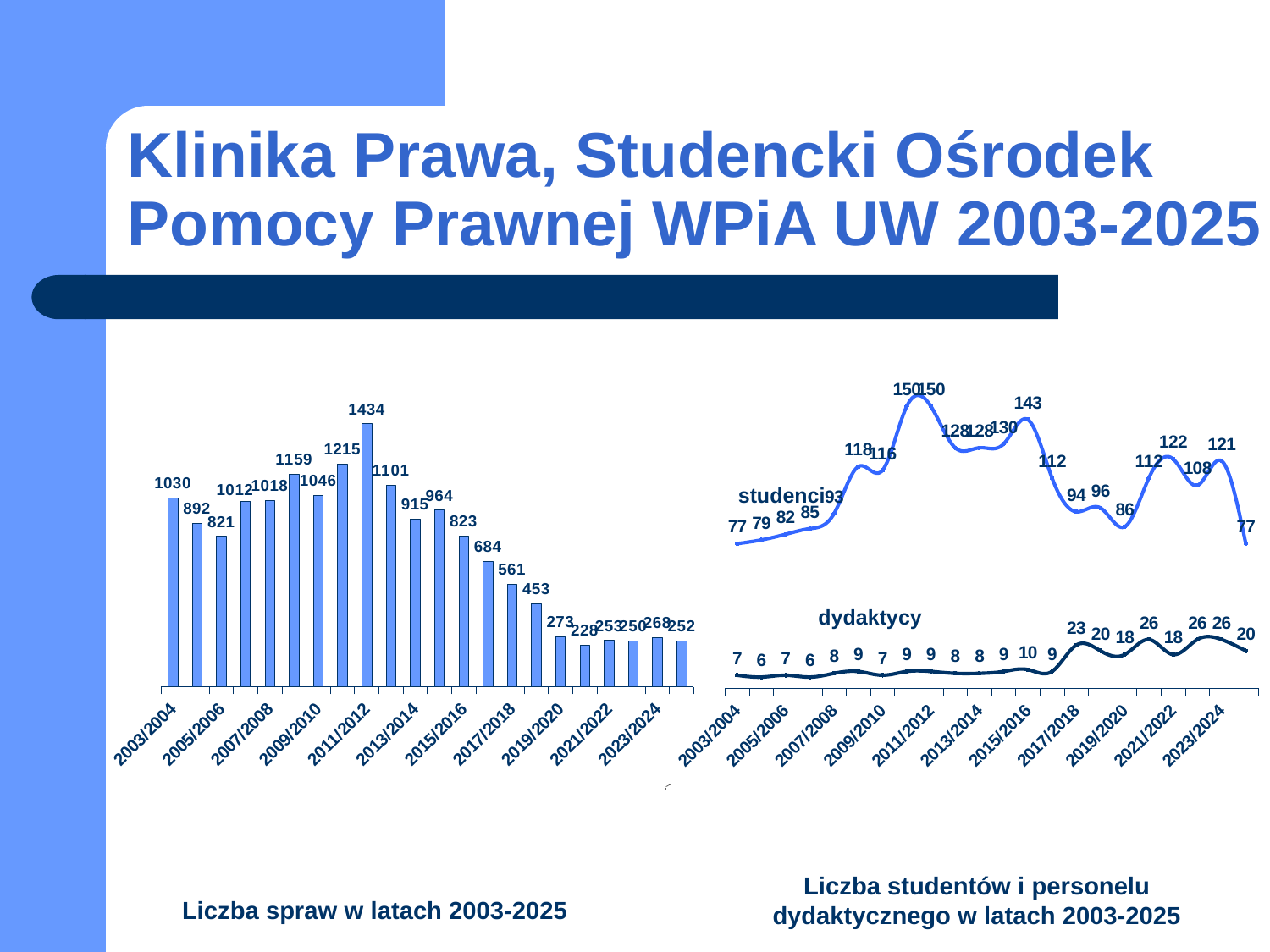
In the chart 'Liczba spraw w latach 2003-2025', which year has the highest value? 2011/2012 In the chart 'Liczba spraw w latach 2003-2025', how many bars are plotted? 22 What kind of chart is 'Liczba studentów i personelu dydaktycznego w latach 2003-2025'? line chart What kind of chart is 'Liczba spraw w latach 2003-2025'? bar chart In the chart 'Liczba studentów i personelu dydaktycznego w latach 2003-2025', what is the value of 'dydaktycy' for 2017/2018? 23 In the chart 'Liczba spraw w latach 2003-2025', what is the value for 2011/2012? 1434 In the chart 'Liczba spraw w latach 2003-2025', which is larger, the value for 2005/2006 or the value for 2007/2008? 2007/2008 In the chart 'Liczba studentów i personelu dydaktycznego w latach 2003-2025', what is the value of 'studenci' for 2015/2016? 143 In the chart 'Liczba spraw w latach 2003-2025', what is the difference between the values for 2011/2012 and 2013/2014? 519 In the chart 'Liczba studentów i personelu dydaktycznego w latach 2003-2025', how many series are plotted? 2 In the chart 'Liczba studentów i personelu dydaktycznego w latach 2003-2025', what is the highest value of the 'studenci' series? 150 In the chart 'Liczba spraw w latach 2003-2025', what is the value for 2003/2004? 1030